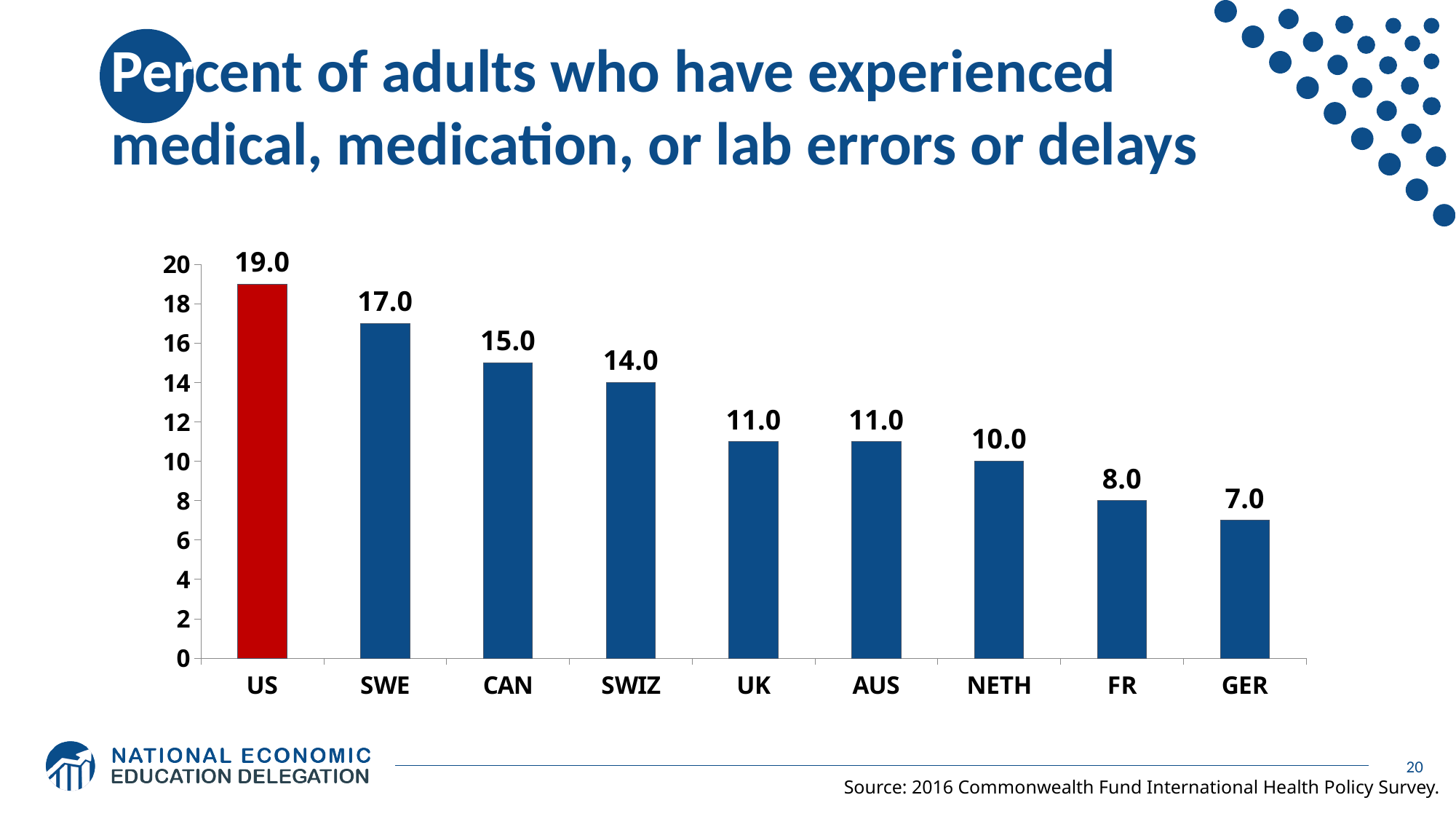
Which country has the highest value? US What kind of chart is shown on the slide? Bar chart How many countries are shown on the chart? 9 What is the difference between the values for the US and SWE? 2.0 Which country has the lowest value? GER What is the value for SWIZ? 14.0 Which is larger, the value for FR or the value for NETH? NETH What is the value for the US? 19.0 What is the value for NETH? 10.0 Which bar is coloured red rather than blue? US Do the values rise or fall from left to right across the chart? Fall What is the difference between the values for CAN and GER? 8.0